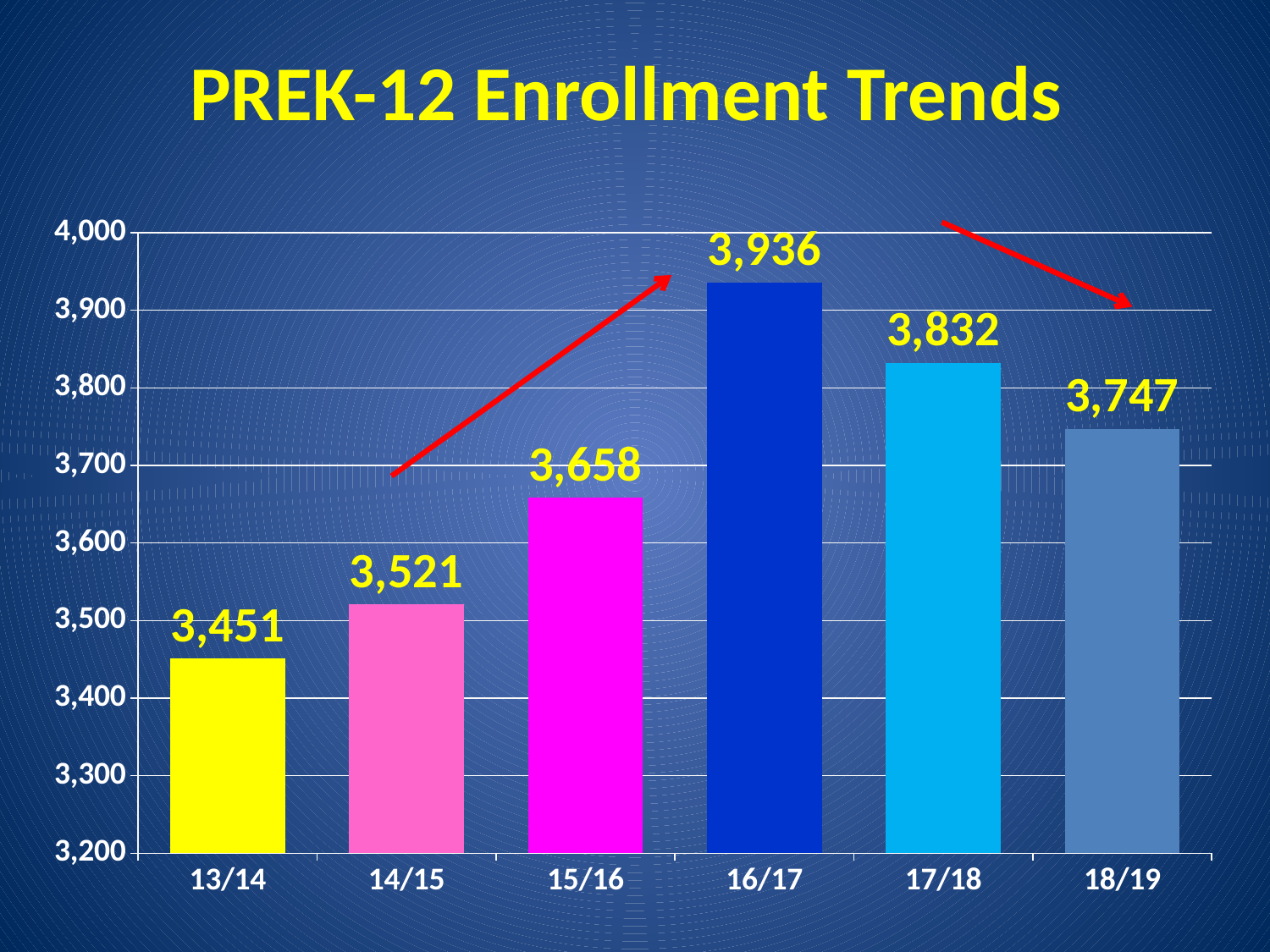
What kind of chart is shown on the slide? bar chart Which school year has the lowest enrollment? 13/14 What is the enrollment value for 13/14? 3,451 Which has a larger enrollment, 17/18 or 18/19? 17/18 What is the enrollment value for 16/17? 3,936 What is the difference in enrollment between 16/17 and 17/18? 104 What is the title of the chart? PREK-12 Enrollment Trends What is the enrollment value for 18/19? 3,747 How many school years are shown on the chart? 6 Is the enrollment value for 15/16 greater or less than 3,700? less What is the difference in enrollment between 15/16 and 14/15? 137 Which school year has the highest enrollment? 16/17